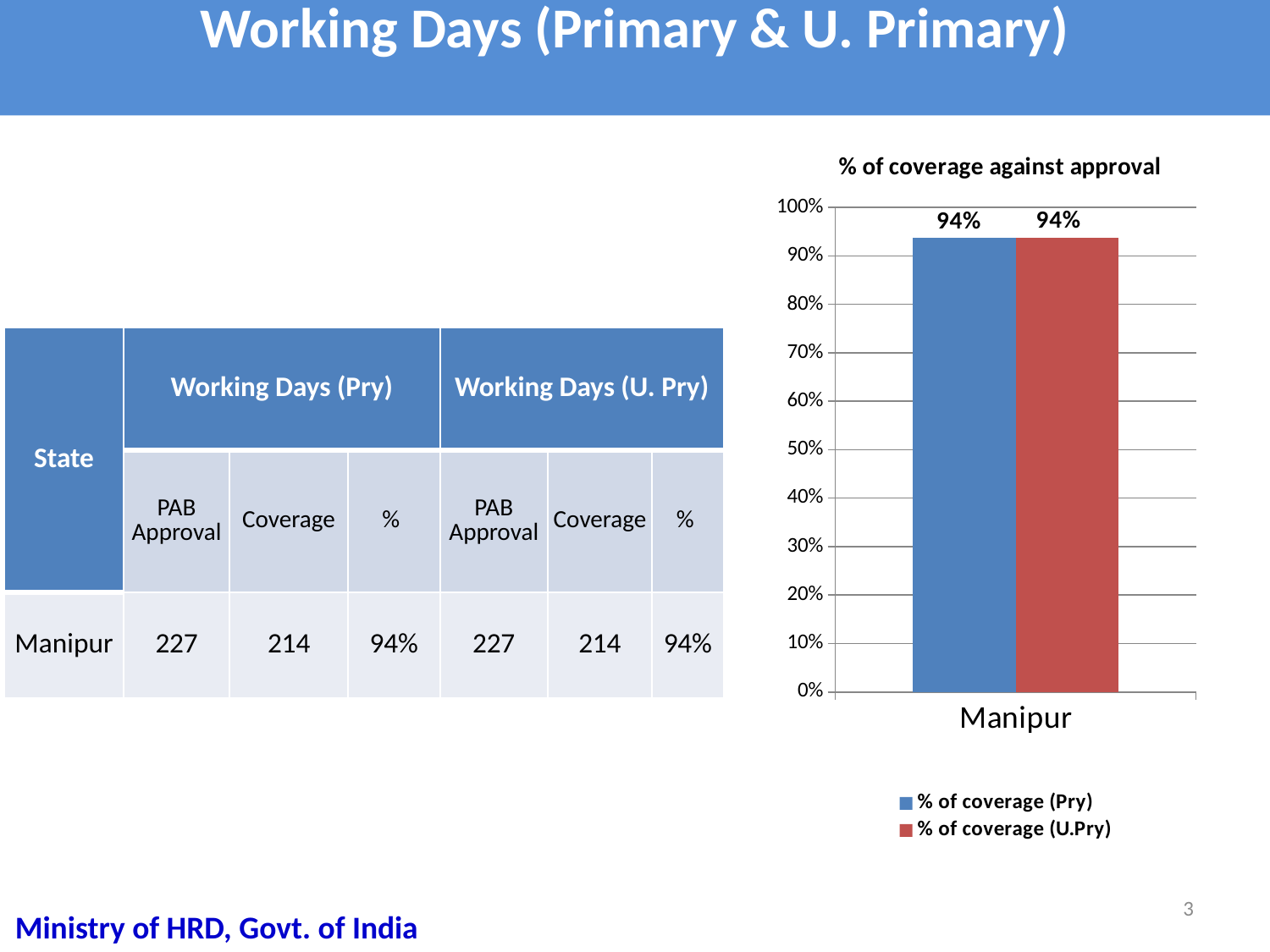
What is the highest value shown on the chart's y axis? 100% What is the value of % of coverage (Pry) for Manipur? 94% What is the value of % of coverage (U.Pry) for Manipur? 94% How many series does the chart's legend list? 2 What is the difference between % of coverage (Pry) and % of coverage (U.Pry) for Manipur? 0% What kind of chart is shown on the slide? bar chart Is the value for % of coverage (Pry) for Manipur greater or less than 90%? greater Which series is shown in red in the chart? % of coverage (U.Pry) Is the value for % of coverage (U.Pry) for Manipur greater or less than 100%? less How many categories are shown on the x axis of the chart? 1 What is the title of the chart? % of coverage against approval